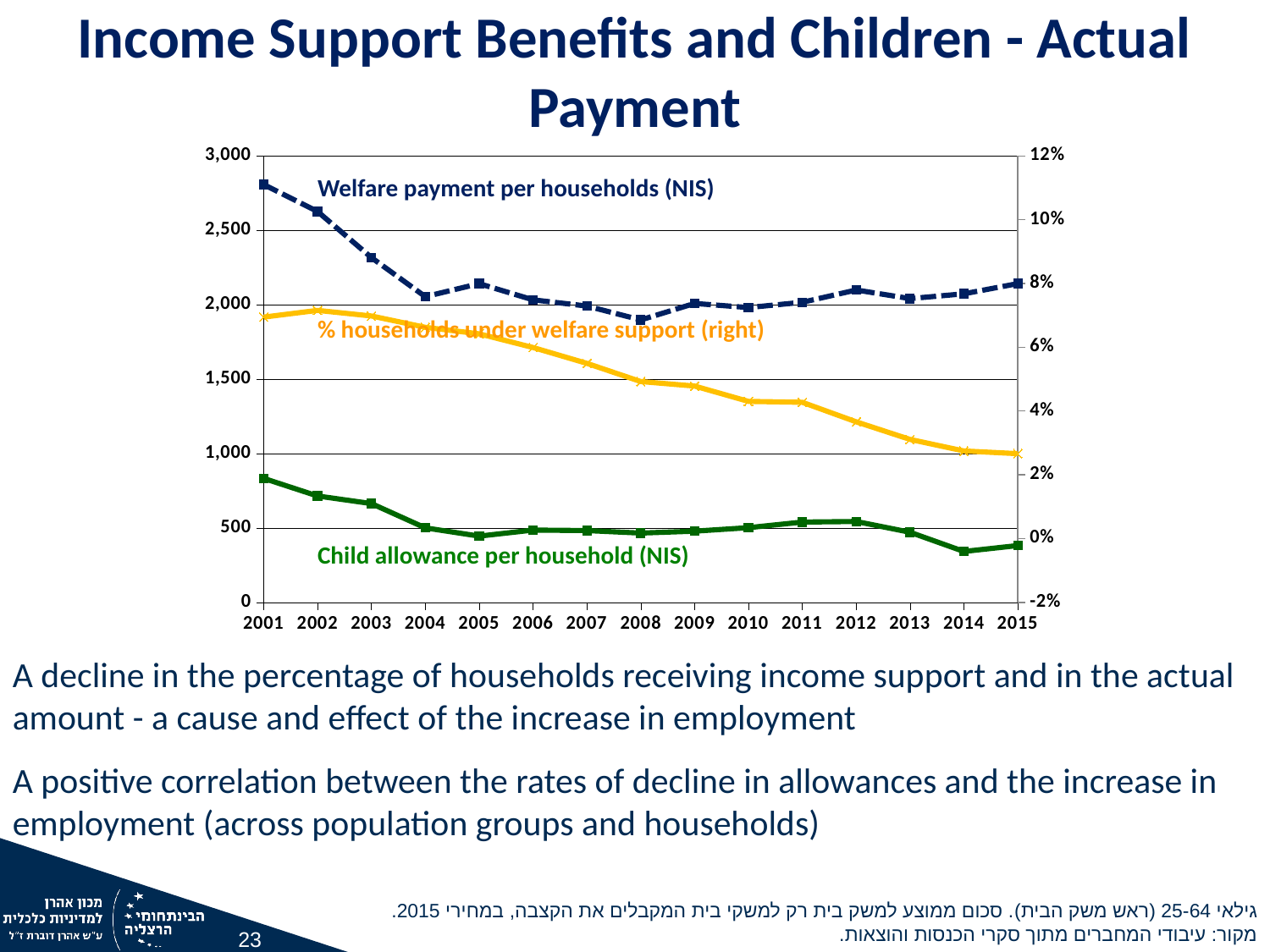
Is the value for Child allowance per household (NIS) in 2001 greater or less than 500? greater In which year is Child allowance per household (NIS) lowest? 2014 In which year is Welfare payment per households (NIS) highest? 2001 Does the % households under welfare support series rise or fall from 2001 to 2015? fall Is the value for Welfare payment per households (NIS) in 2015 greater or less than 2,000? greater Is the value for Welfare payment per households (NIS) in 2001 greater or less than 2,500? greater Which is larger, Welfare payment per households (NIS) in 2001 or in 2015? 2001 How many years are shown along the x axis of the chart? 15 What kind of chart is shown on the slide? line chart How many data series are plotted on the chart? 3